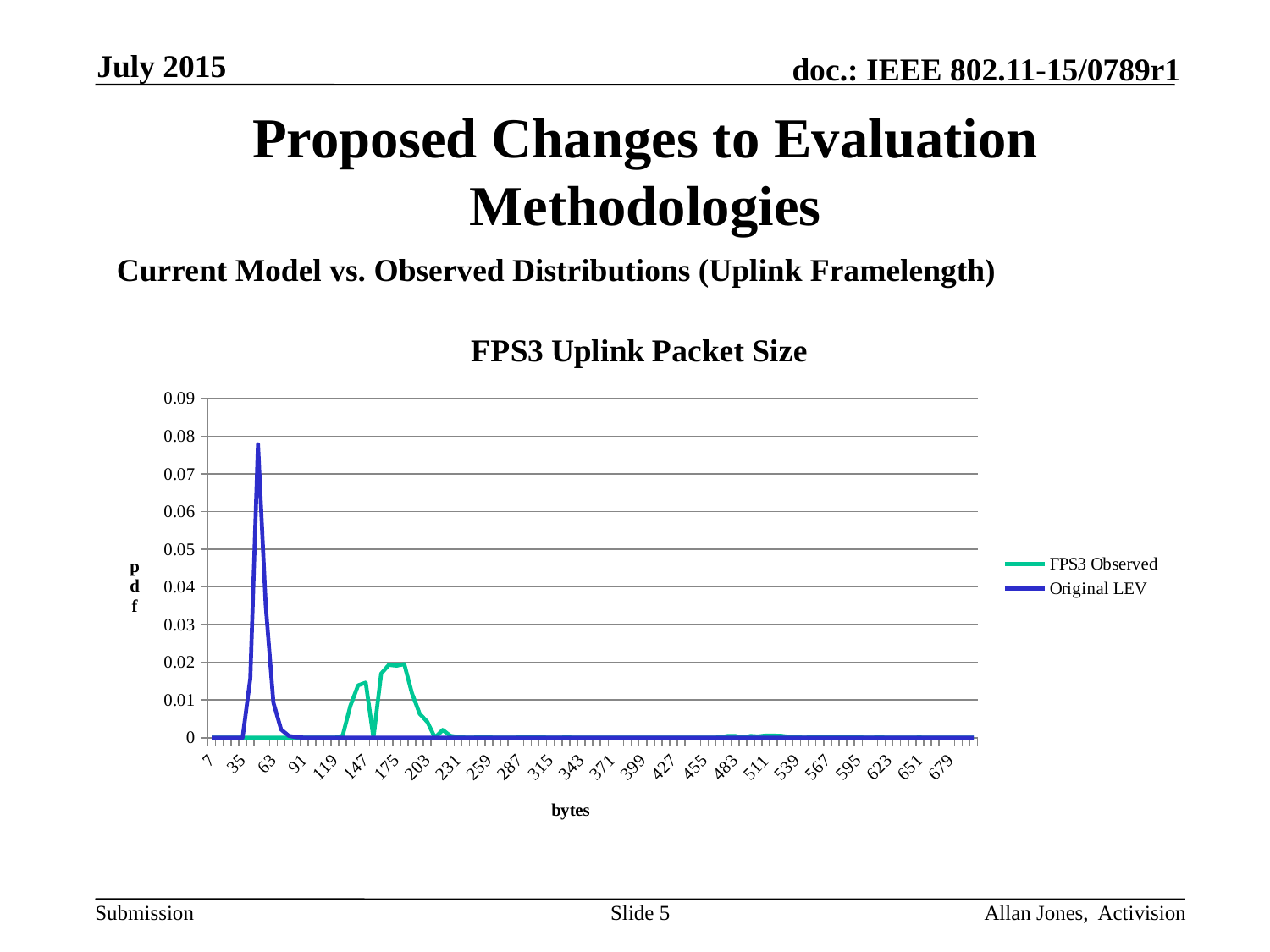
Is the FPS3 Observed value at 175 bytes greater or less than 0.01? greater Is the peak value of the FPS3 Observed series greater or less than 0.03? less Which series reaches the higher peak value, FPS3 Observed or Original LEV? Original LEV How many series does the chart legend list? 2 What is the label of the x axis? bytes What is the title of the chart? FPS3 Uplink Packet Size Is the peak value of the Original LEV series greater or less than 0.07? greater What is the highest value shown on the y axis? 0.09 Does the Original LEV line rise or fall between 63 and 91 bytes? fall Which series reaches its peak at a lower byte value, FPS3 Observed or Original LEV? Original LEV What type of chart is shown on the slide? line chart